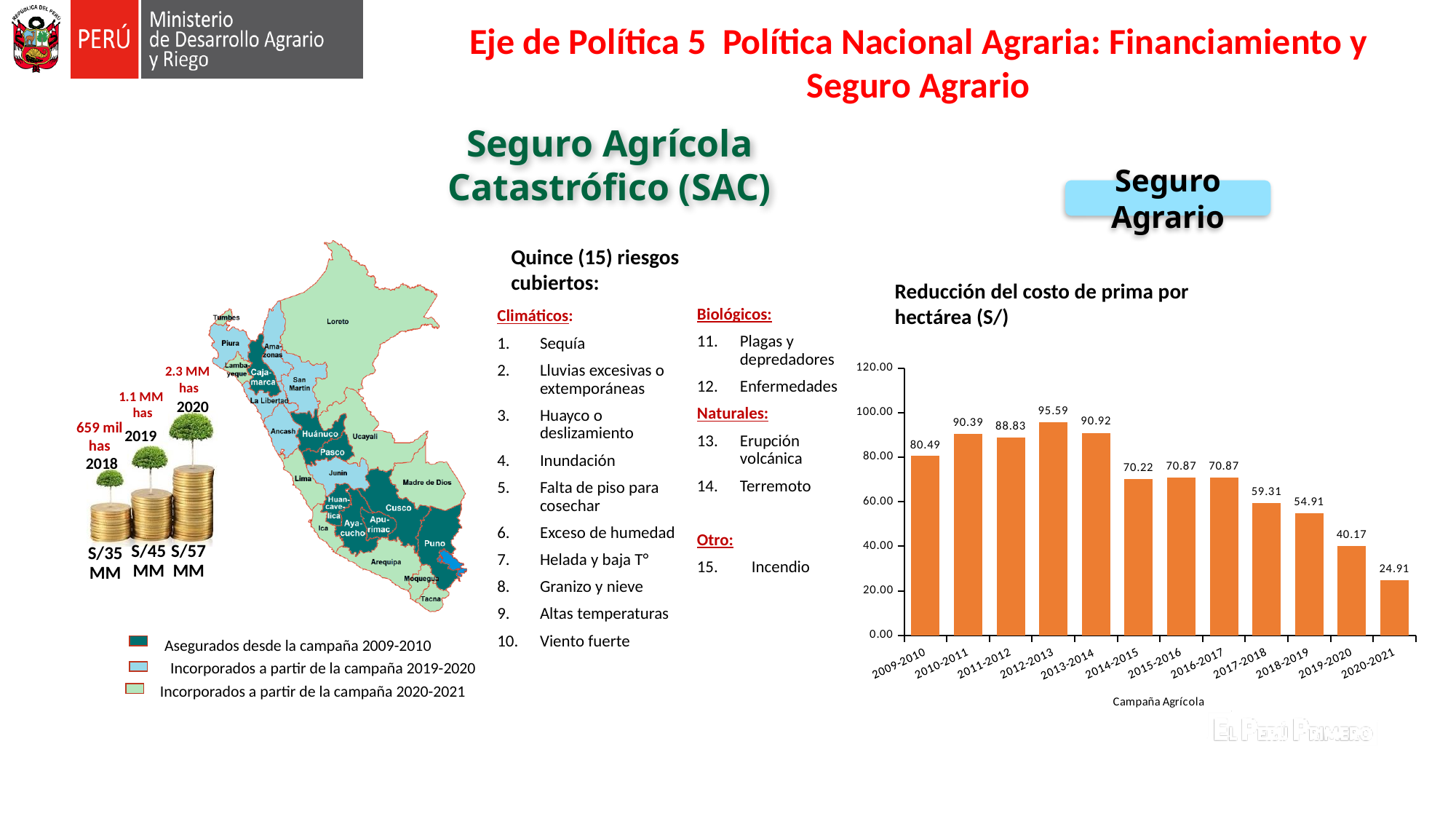
What is the value for 2012-2013 in the 'Reducción del costo de prima por hectárea (S/)' chart? 95.59 In the 'Reducción del costo de prima por hectárea (S/)' chart, what is the difference between the values for 2012-2013 and 2020-2021? 70.68 What is the value for 2009-2010 in the 'Reducción del costo de prima por hectárea (S/)' chart? 80.49 What is the x-axis label of the 'Reducción del costo de prima por hectárea (S/)' chart? Campaña Agrícola How many campaigns are shown on the x axis of the 'Reducción del costo de prima por hectárea (S/)' chart? 12 In the 'Reducción del costo de prima por hectárea (S/)' chart, which is larger: the value for 2010-2011 or the value for 2011-2012? 2010-2011 Which campaign has the lowest value in the 'Reducción del costo de prima por hectárea (S/)' chart? 2020-2021 In the 'Reducción del costo de prima por hectárea (S/)' chart, is the value for 2017-2018 greater or less than 60.00? less What kind of chart is the 'Reducción del costo de prima por hectárea (S/)' chart? bar chart Which campaign has the highest value in the 'Reducción del costo de prima por hectárea (S/)' chart? 2012-2013 In the 'Reducción del costo de prima por hectárea (S/)' chart, do the values generally rise or fall from 2013-2014 to 2020-2021? fall What is the value for 2020-2021 in the 'Reducción del costo de prima por hectárea (S/)' chart? 24.91